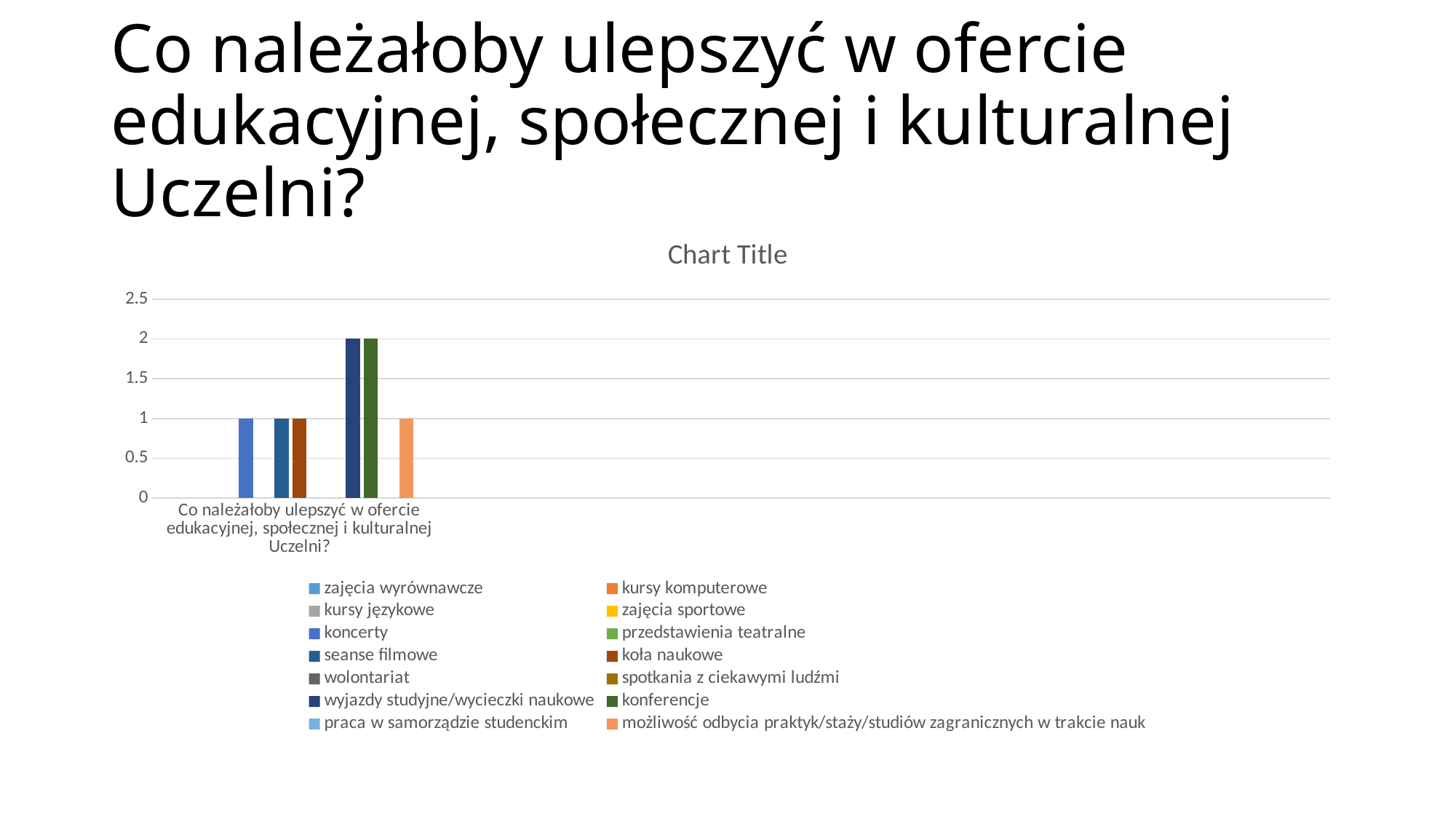
What is the difference between the value for konferencje and the value for koncerty? 1 How many series does the legend list? 14 What is the value for konferencje? 2 What is the value for możliwość odbycia praktyk/staży/studiów zagranicznych w trakcie nauk? 1 What is the value for wyjazdy studyjne/wycieczki naukowe? 2 What kind of chart is shown on the slide? bar chart What is the value for koncerty? 1 What is the title shown above the chart? Chart Title Which is larger, the value for konferencje or the value for seanse filmowe? konferencje What is the value for koła naukowe? 1 Is the value for wyjazdy studyjne/wycieczki naukowe greater or less than 1.5? greater How many categories are shown on the x axis? 1